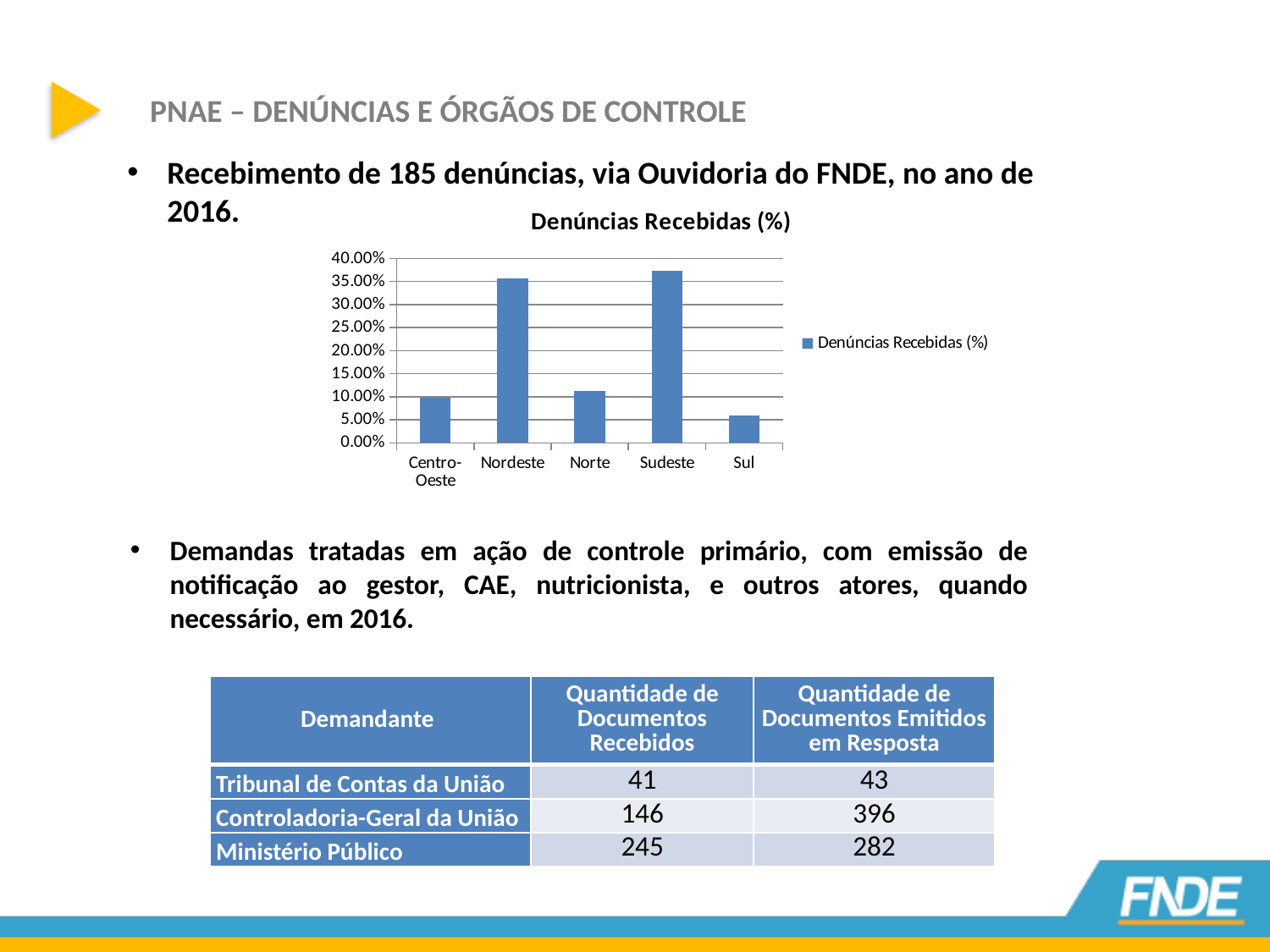
How many series does the chart's legend list? 1 Which has the larger value, Nordeste or Norte? Nordeste Which has the larger value, Norte or Sul? Norte Is the value for Sudeste greater or less than 35.00%? greater Is the value for Centro-Oeste greater or less than 5.00%? greater Is the value for Sul greater or less than 10.00%? less What kind of chart is shown on the slide? bar chart Which region has the lowest value in the chart? Sul What is the title of the chart on the slide? Denúncias Recebidas (%) How many regions (categories) are shown on the x axis of the chart? 5